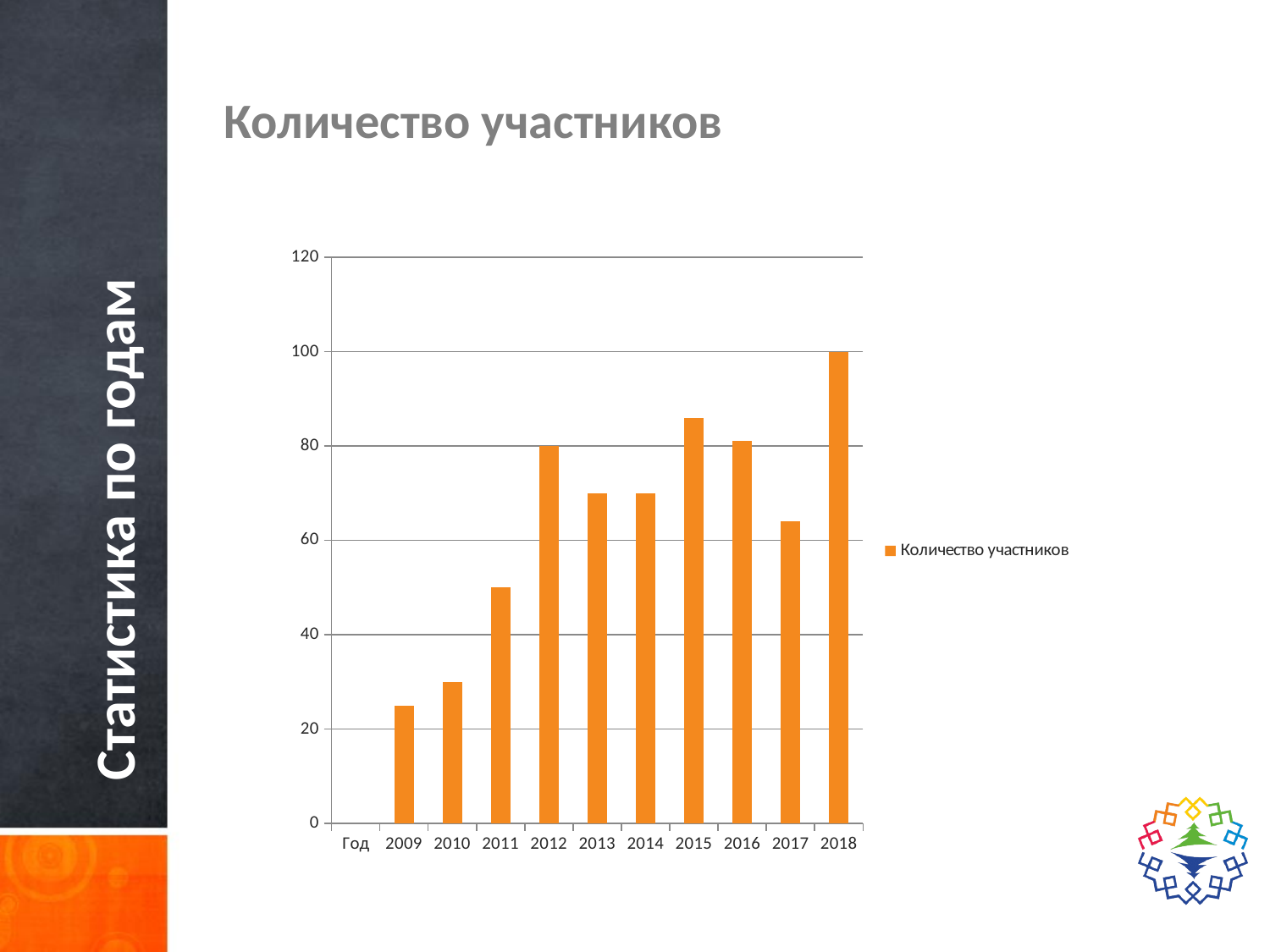
How many series does the legend list? 1 What is the difference between the values for 2018 and 2012? 20 What type of chart is shown on the slide? bar chart Is the value for 2011 greater or less than 40? greater How many years are shown on the x axis of the chart? 10 What is the title of the chart? Количество участников Which is larger, the value for 2012 or the value for 2013? 2012 Which year has the lowest number of participants? 2009 Which year has the highest number of participants? 2018 What is the value for 2012? 80 Is the value for 2017 greater or less than 80? less What is the value for 2018? 100